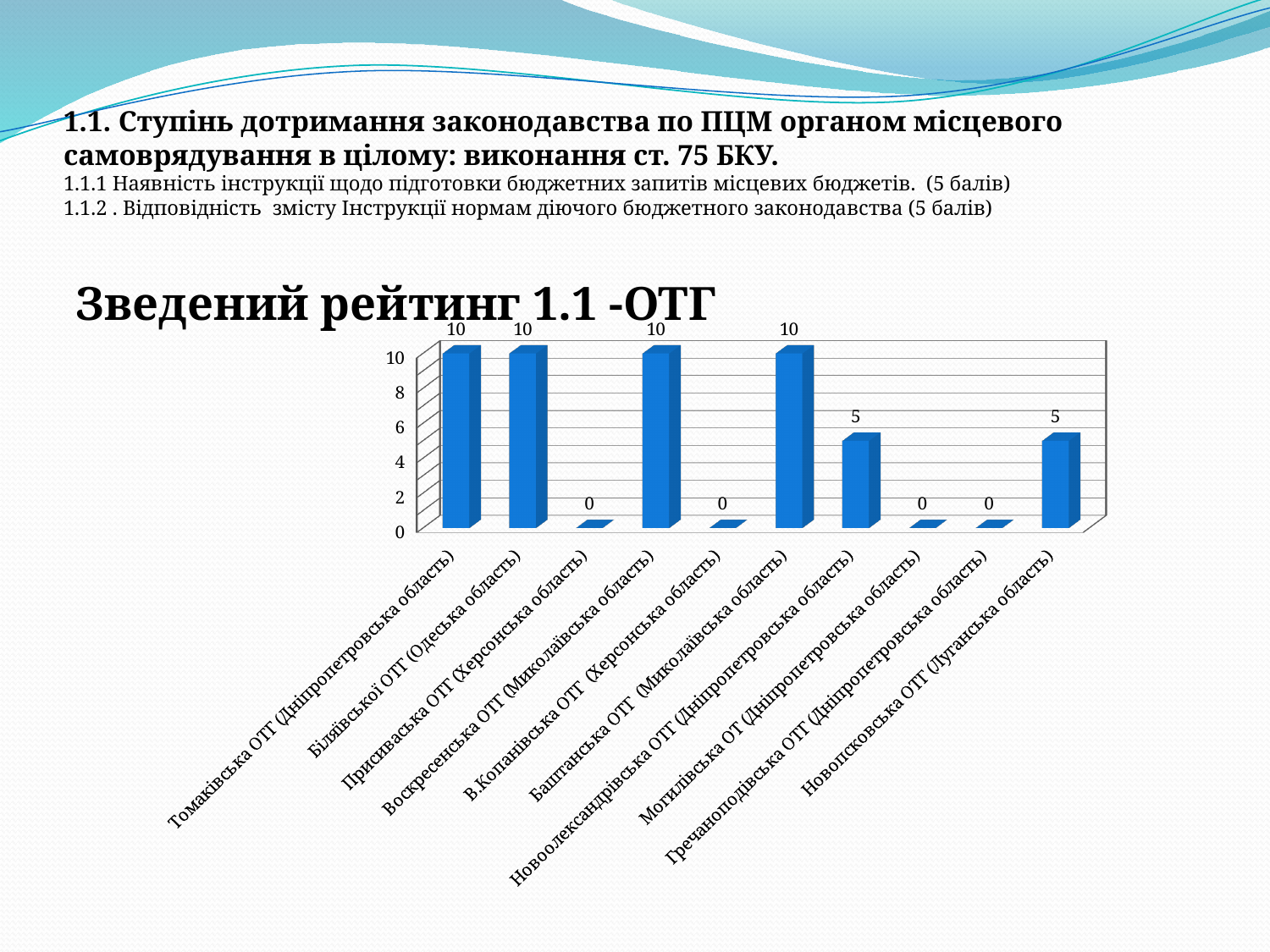
What kind of chart is shown on the slide? Bar chart Which has the larger value: Біляївської ОТГ (Одеська область) or Новоолександрівська ОТГ (Дніпропетровська область)? Біляївської ОТГ (Одеська область) What value is shown for Новоолександрівська ОТГ (Дніпропетровська область)? 5 How many categories have a value of 0? 4 What is the title of the chart? Зведений рейтинг 1.1 -ОТГ What value is shown for Баштанська ОТГ (Миколаївська область)? 10 Which has the larger value: Новопсковська ОТГ (Луганська область) or Гречанопідівська ОТГ (Дніпропетровська область)? Новопсковська ОТГ (Луганська область) What value is shown for Томаківська ОТГ (Дніпропетровська область)? 10 What value is shown for Присиваська ОТГ (Херсонська область)? 0 What value is shown for Новопсковська ОТГ (Луганська область)? 5 What is the difference between the values for Воскресенська ОТГ (Миколаївська область) and Новопсковська ОТГ (Луганська область)? 5 How many categories are shown on the x axis of the chart? 10